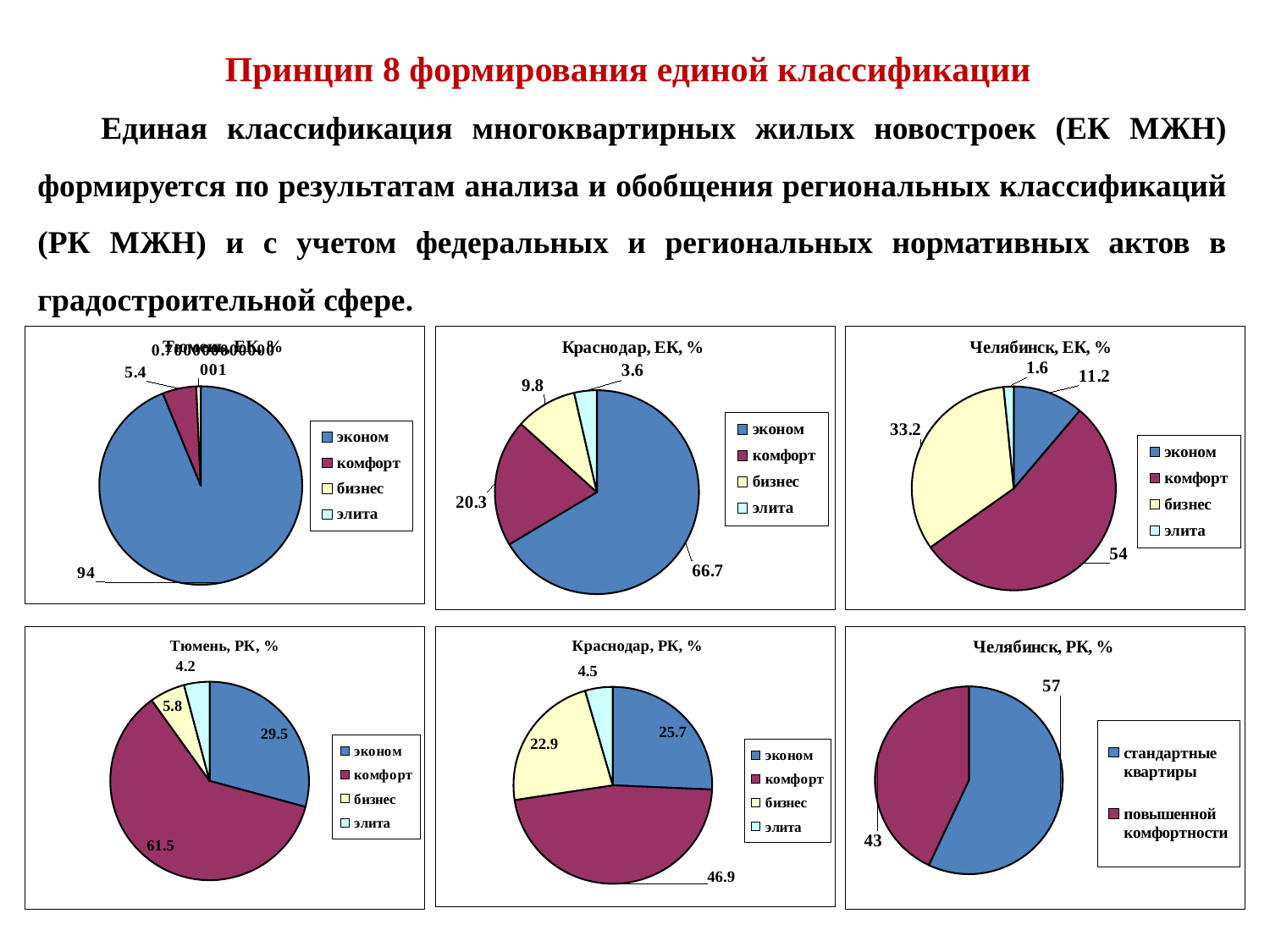
In the "Челябинск, ЕК, %" chart, which category has the smallest share? элита In the "Краснодар, РК, %" chart, what is the value for элита? 4.5 In the "Челябинск, РК, %" chart, what is the value for стандартные квартиры? 57 In the "Краснодар, ЕК, %" chart, what is the value for эконом? 66.7 In the "Тюмень, РК, %" chart, what is the value for комфорт? 61.5 In the "Челябинск, ЕК, %" chart, what is the difference between the комфорт and бизнес values? 20.8 What type of chart is the "Краснодар, ЕК, %" chart? pie chart In the "Тюмень, РК, %" chart, which is larger, бизнес or элита? бизнес How many entries does the legend of the "Челябинск, РК, %" chart list? 2 In the "Краснодар, РК, %" chart, what is the difference between the комфорт and эконом values? 21.2 In the "Челябинск, ЕК, %" chart, which category has the largest share? комфорт In the "Краснодар, ЕК, %" chart, what is the value for бизнес? 9.8